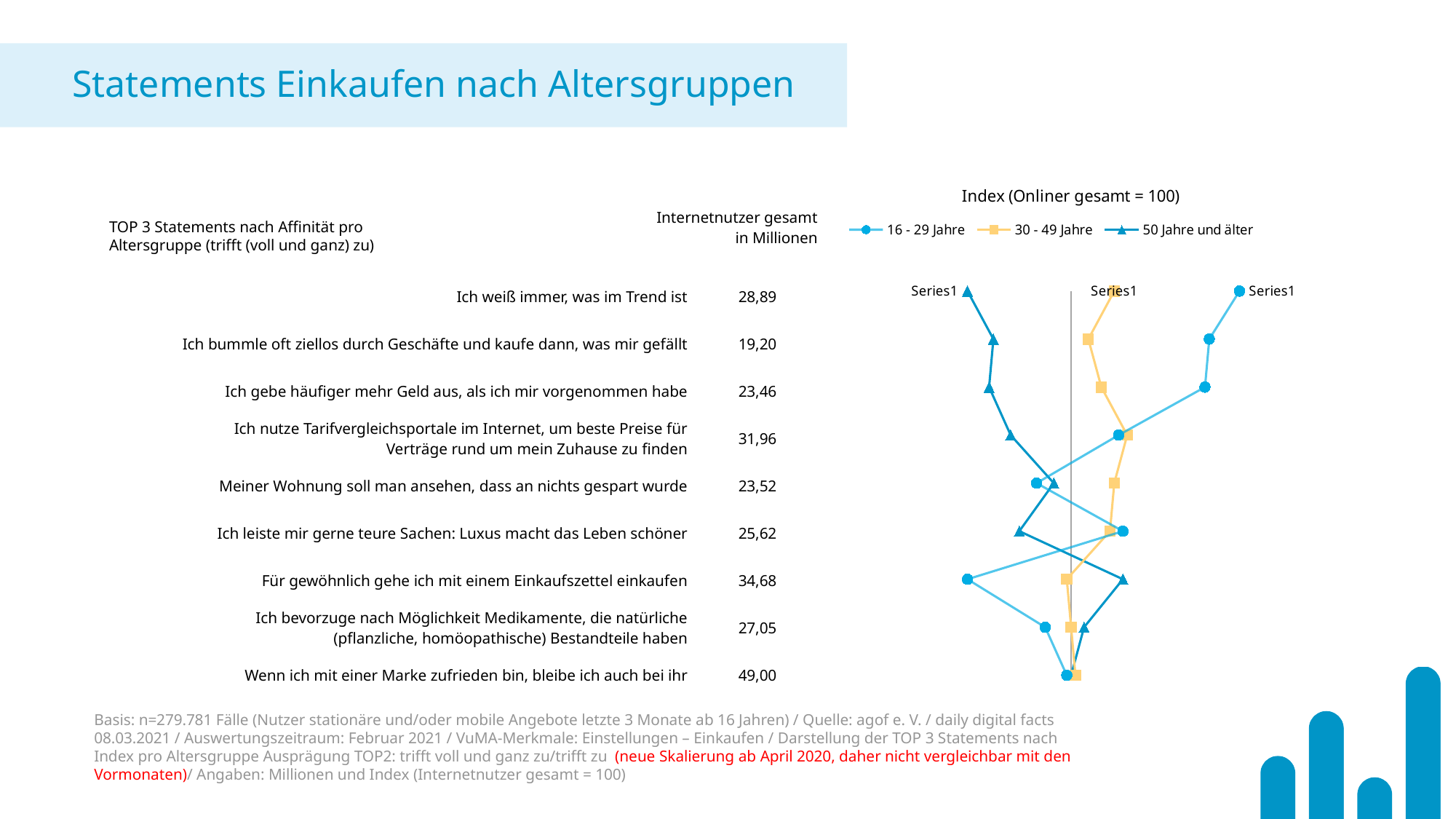
How many series does the chart legend list? 3 For 'Für gewöhnlich gehe ich mit einem Einkaufszettel einkaufen', which series has the higher index value: '16 - 29 Jahre' or '50 Jahre und älter'? 50 Jahre und älter Which age groups are listed in the chart legend? 16 - 29 Jahre, 30 - 49 Jahre, 50 Jahre und älter What is the difference in 'Internetnutzer gesamt in Millionen' between 'Wenn ich mit einer Marke zufrieden bin, bleibe ich auch bei ihr' and 'Für gewöhnlich gehe ich mit einem Einkaufszettel einkaufen'? 14,32 How many statements are plotted in the chart? 9 Which statement has the lowest value in the column 'Internetnutzer gesamt in Millionen'? Ich bummle oft ziellos durch Geschäfte und kaufe dann, was mir gefällt What is the value in the column 'Internetnutzer gesamt in Millionen' for 'Wenn ich mit einer Marke zufrieden bin, bleibe ich auch bei ihr'? 49,00 What is the title shown above the chart legend? Index (Onliner gesamt = 100) Is the index value of the series '16 - 29 Jahre' for 'Ich weiß immer, was im Trend ist' greater or less than 100? greater Which statement has the highest value in the column 'Internetnutzer gesamt in Millionen'? Wenn ich mit einer Marke zufrieden bin, bleibe ich auch bei ihr What is the value in the column 'Internetnutzer gesamt in Millionen' for 'Ich weiß immer, was im Trend ist'? 28,89 What kind of chart is shown on the slide? line chart